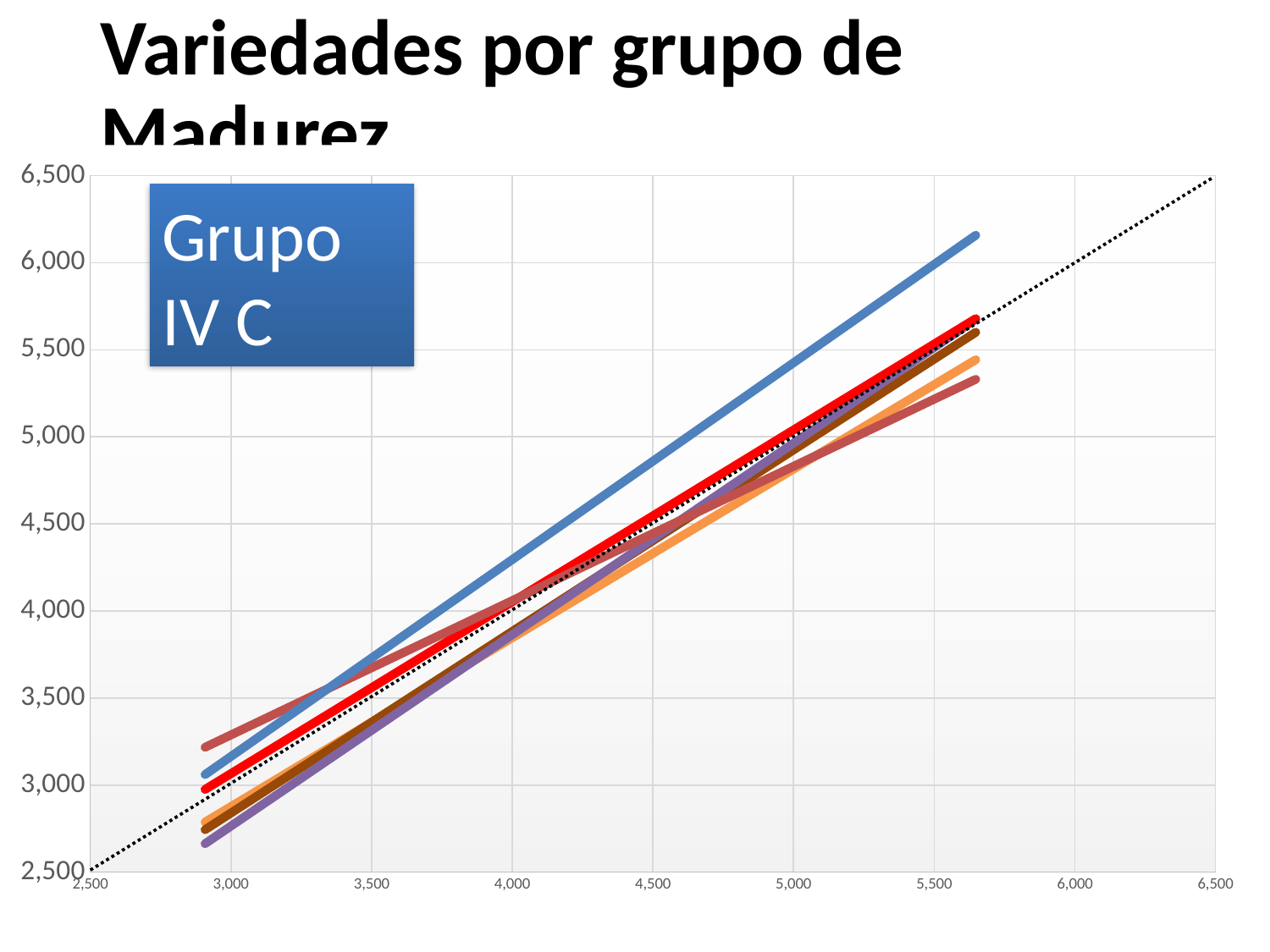
What kind of chart is shown on the slide? Line chart What is the title of the chart on the slide? Variedades por grupo de Madurez Is the right-hand end of the red line greater or less than 5,500? greater Do the plotted lines rise or fall as the x-axis values increase? Rise Is the right-hand end of the red line greater or less than 6,000? less Which coloured line reaches the highest value at the right end of the chart? The light blue line Is the highest point of the light blue line greater or less than 6,000? greater At the right end of the chart, which is higher: the light blue line or the red line? The light blue line What label appears in the blue box inside the chart? Grupo IV C At the left end of the chart, which starts higher: the light blue line or the purple line? The light blue line